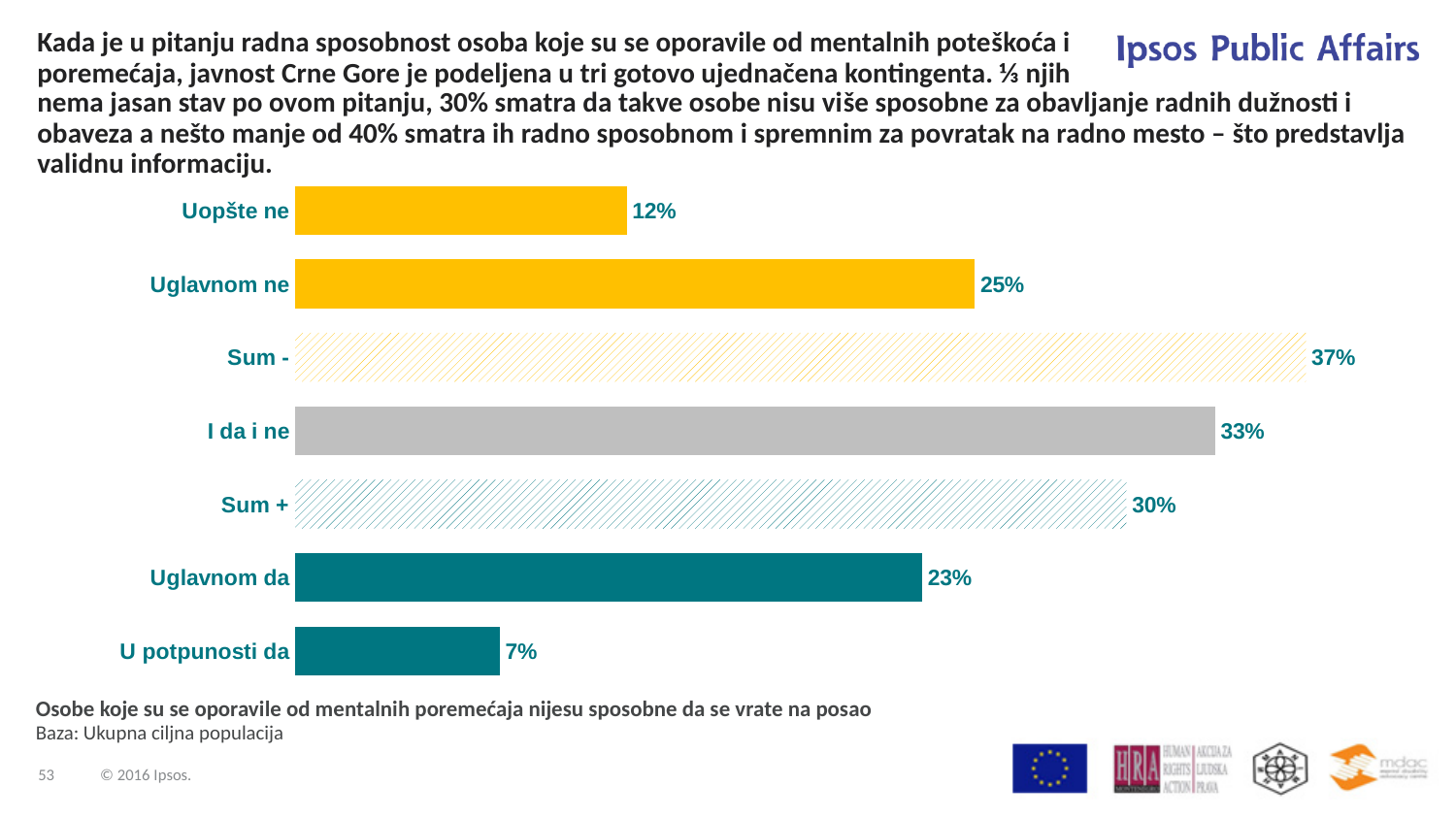
What is the value for "Sum +"? 30% What is the difference between the values for "Sum -" and "Sum +"? 7% What is the difference between the values for "Uglavnom da" and "U potpunosti da"? 16% Which is larger, the value for "Uglavnom ne" or the value for "Uglavnom da"? Uglavnom ne What is the value for "Uglavnom ne"? 25% Which category has the highest value? Sum - How many categories are shown in the chart? 7 What is the value for "Uopšte ne"? 12% What is the value for "I da i ne"? 33% Which category has the lowest value? U potpunosti da What is the value for "U potpunosti da"? 7% What kind of chart is shown on the slide? Bar chart